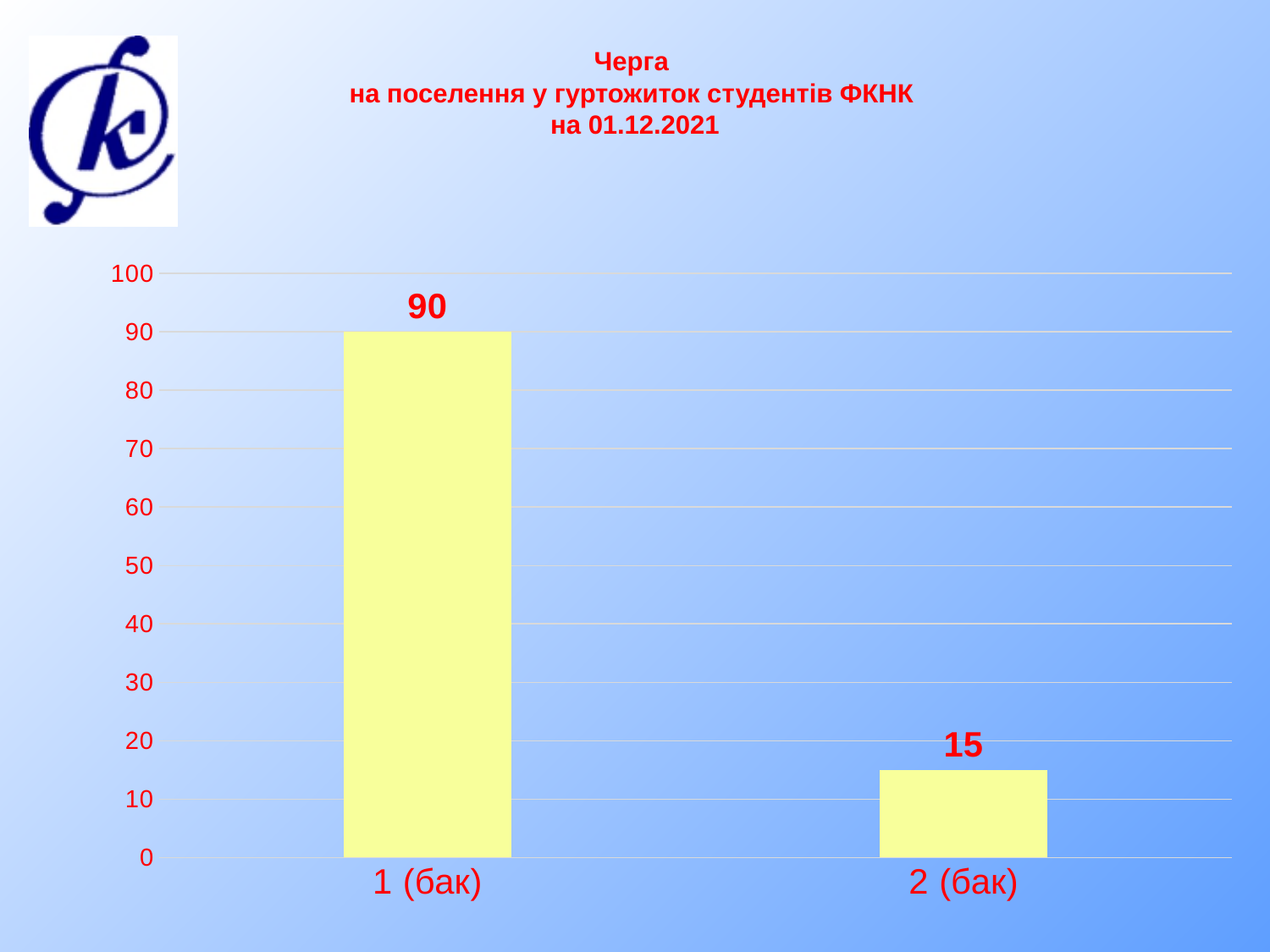
Is the value for 1 (бак) greater or less than 80? greater What is the difference between the values for 1 (бак) and 2 (бак)? 75 Which is larger, the value for 1 (бак) or the value for 2 (бак)? 1 (бак) Which category has the highest value? 1 (бак) Do the values rise or fall from 1 (бак) to 2 (бак)? fall Is the value for 2 (бак) greater or less than 20? less How many categories are shown on the x axis? 2 What is the value for 1 (бак)? 90 Which category has the lowest value? 2 (бак) What is the highest value shown on the vertical axis? 100 What kind of chart is shown on the slide? bar chart What is the value for 2 (бак)? 15